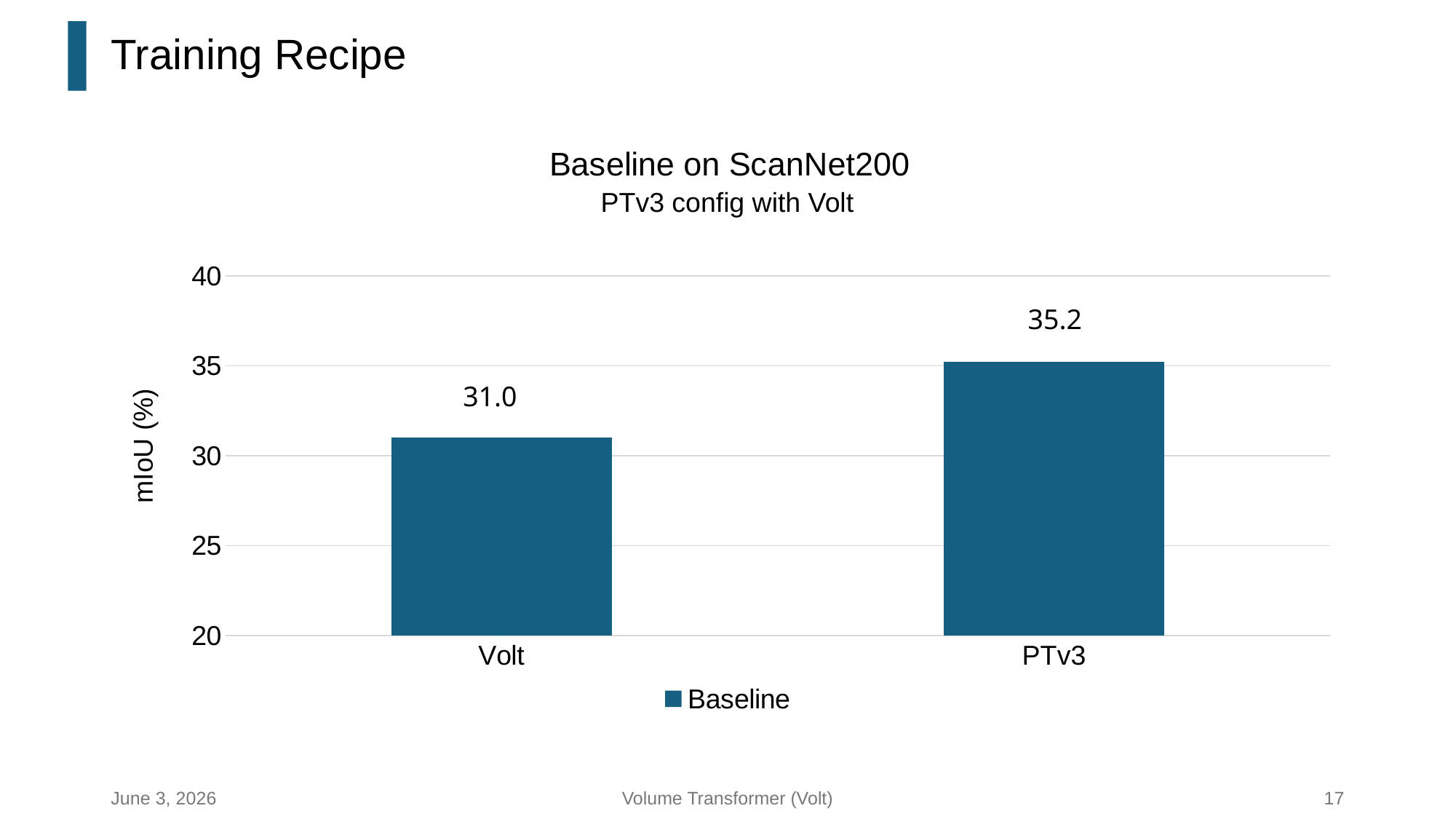
Which category has the highest mIoU? PTv3 Which has a larger mIoU, Volt or PTv3? PTv3 What is the mIoU (%) value for PTv3? 35.2 How many series does the legend list? 1 What is the mIoU (%) value for Volt? 31.0 What kind of chart is shown on the slide? bar chart Which category has the lowest mIoU? Volt Is the value for Volt greater or less than 35? less Is the value for PTv3 greater or less than 35? greater What is the difference in mIoU between PTv3 and Volt? 4.2 How many categories are shown on the x axis? 2 What is the title of the chart? Baseline on ScanNet200